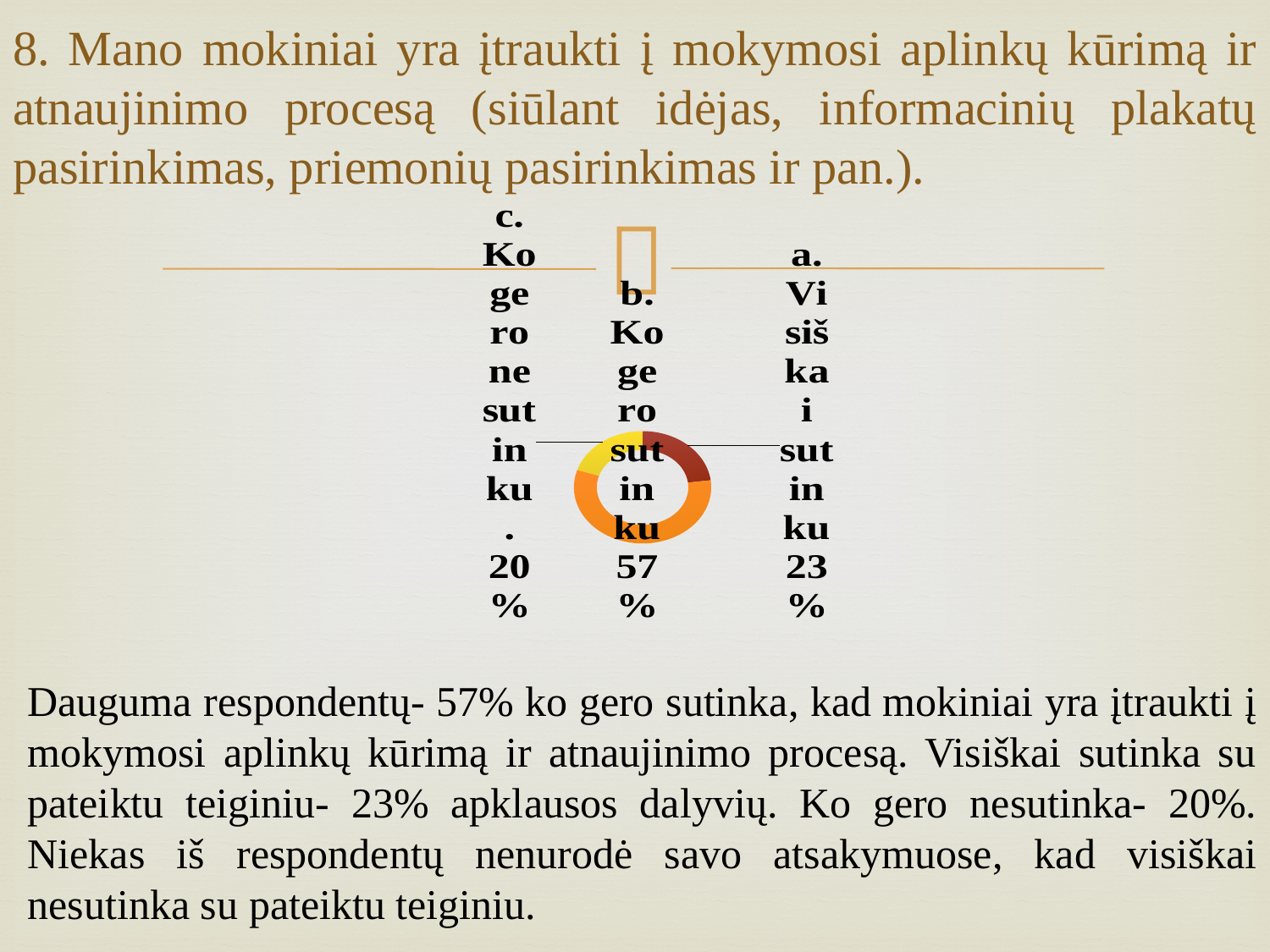
What percentage is shown for "c. Ko gero nesutinku"? 20% Which category has the largest share of the doughnut chart? b. Ko gero sutinku What is the difference in percentage points between "b. Ko gero sutinku" and "a. Visiškai sutinku"? 34 What percentage is shown for "b. Ko gero sutinku"? 57% What is the difference in percentage points between "a. Visiškai sutinku" and "c. Ko gero nesutinku"? 3 Which is larger, the share for "a. Visiškai sutinku" or for "c. Ko gero nesutinku"? a. Visiškai sutinku What kind of chart is shown on the slide? doughnut chart Which colour is used for the largest slice, "b. Ko gero sutinku"? orange What do the three percentages on the doughnut chart add up to? 100% How many categories does the doughnut chart show? 3 What percentage is shown for "a. Visiškai sutinku"? 23% Which category has the smallest share of the doughnut chart? c. Ko gero nesutinku